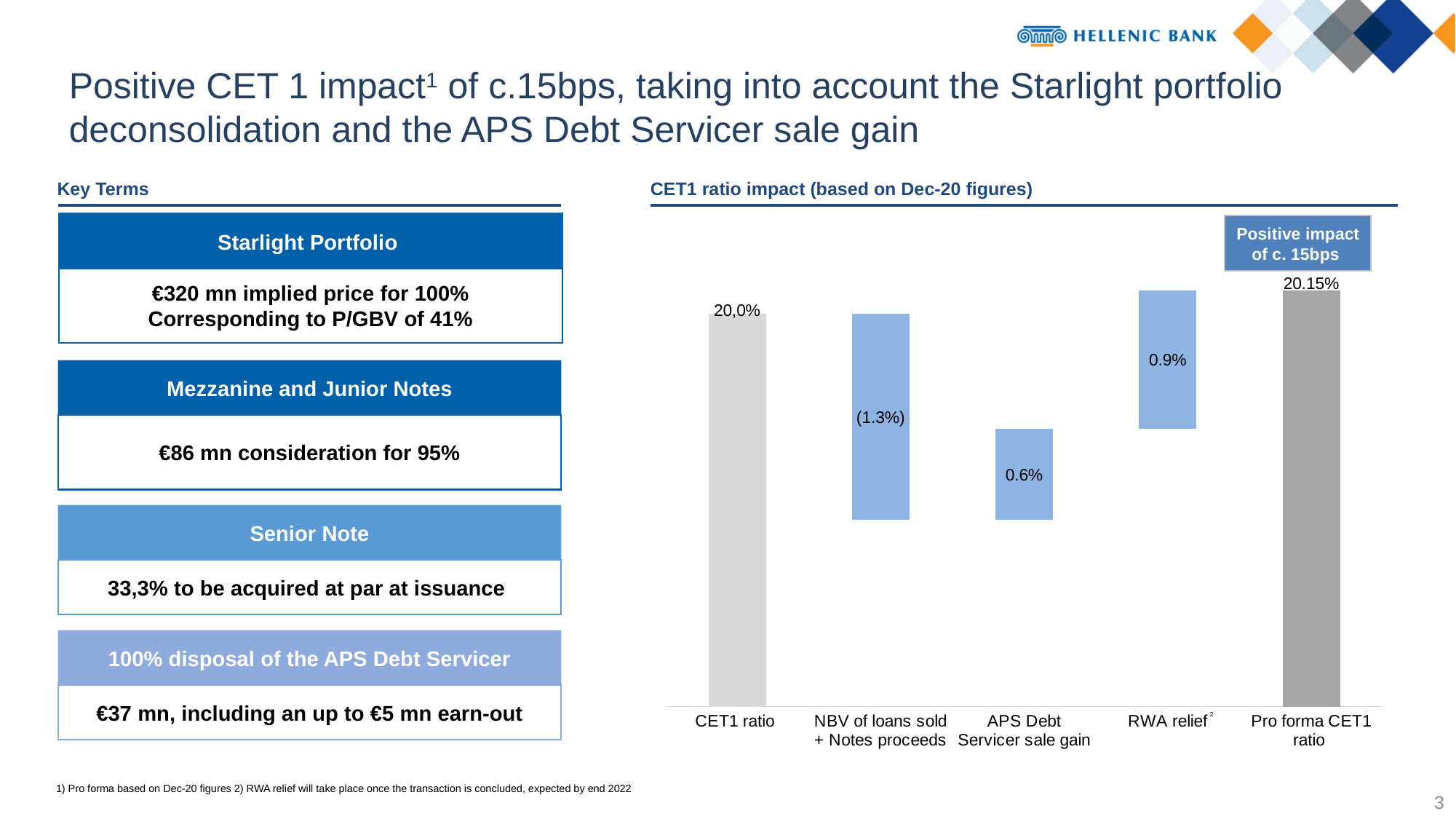
Which is larger, the RWA relief or the APS Debt Servicer sale gain? RWA relief What is the title of the chart? CET1 ratio impact (based on Dec-20 figures) What is the value shown for the APS Debt Servicer sale gain? 0.6% What is the difference between the RWA relief and the APS Debt Servicer sale gain? 0.3% What value is labelled on the NBV of loans sold + Notes proceeds bar? (1.3%) Which category shows a negative impact on the CET1 ratio? NBV of loans sold + Notes proceeds What is the value shown for the CET1 ratio bar? 20,0% How many categories are shown on the x axis of the chart? 5 What is the value shown for RWA relief? 0.9% What kind of chart is used to show the CET1 ratio impact? Bar chart (waterfall) Which category has the highest value in the chart? Pro forma CET1 ratio What is the value shown for the Pro forma CET1 ratio bar? 20.15%